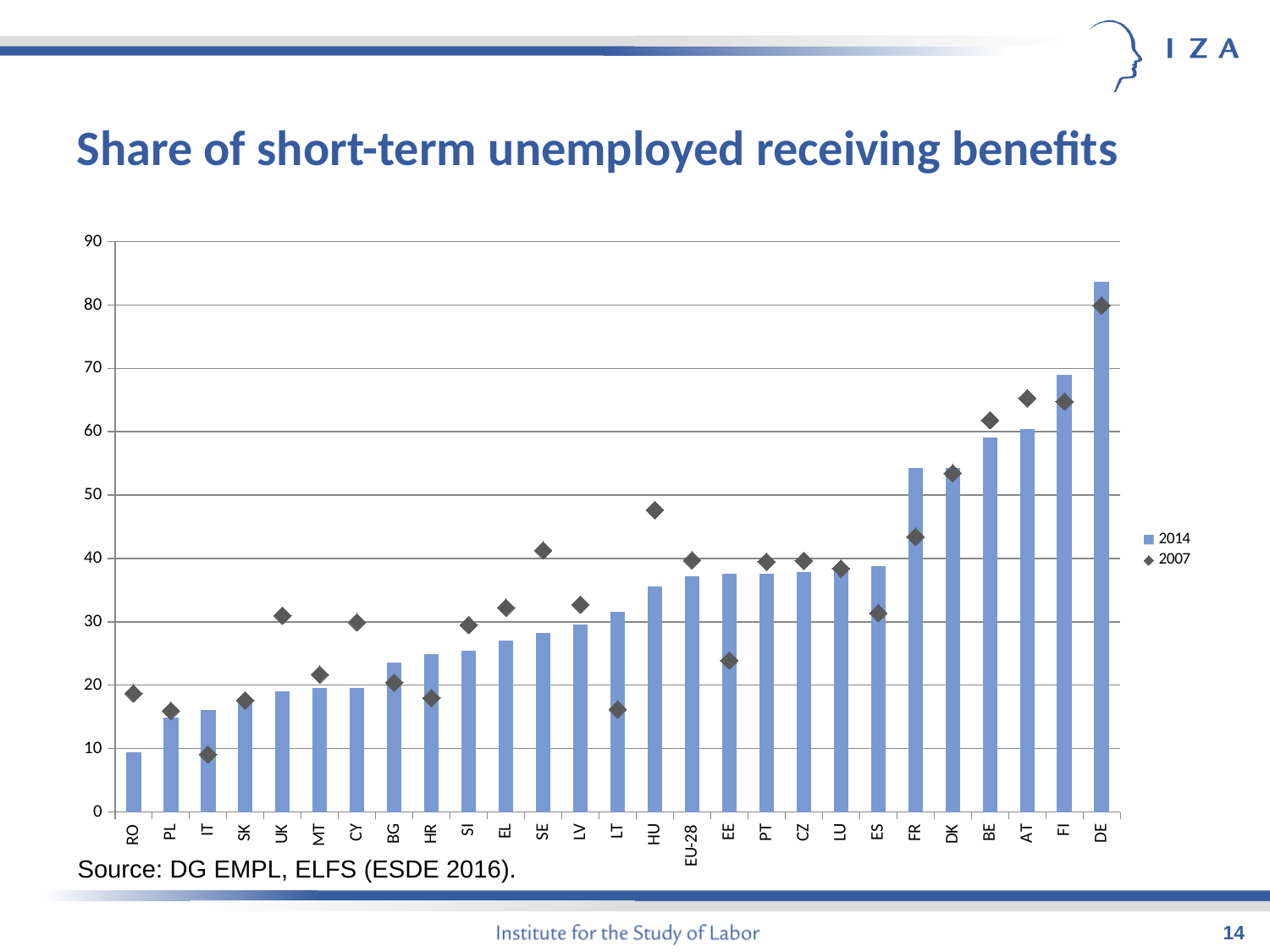
Which category has the lowest 2014 value? RO How many countries/categories are shown on the x axis? 27 Which category has the highest 2014 value? DE What kind of chart is shown on the slide? bar chart (with markers for 2007) How many series does the legend list? 2 Is the 2007 value for HU greater or less than 40? greater For HU, which is larger: the 2014 value or the 2007 value? 2007 Do the 2014 bars rise or fall from left to right along the x axis? rise Is the 2014 value for DE greater or less than 80? greater Is the 2014 value for RO greater or less than 10? less Which category has the lowest 2007 value? IT